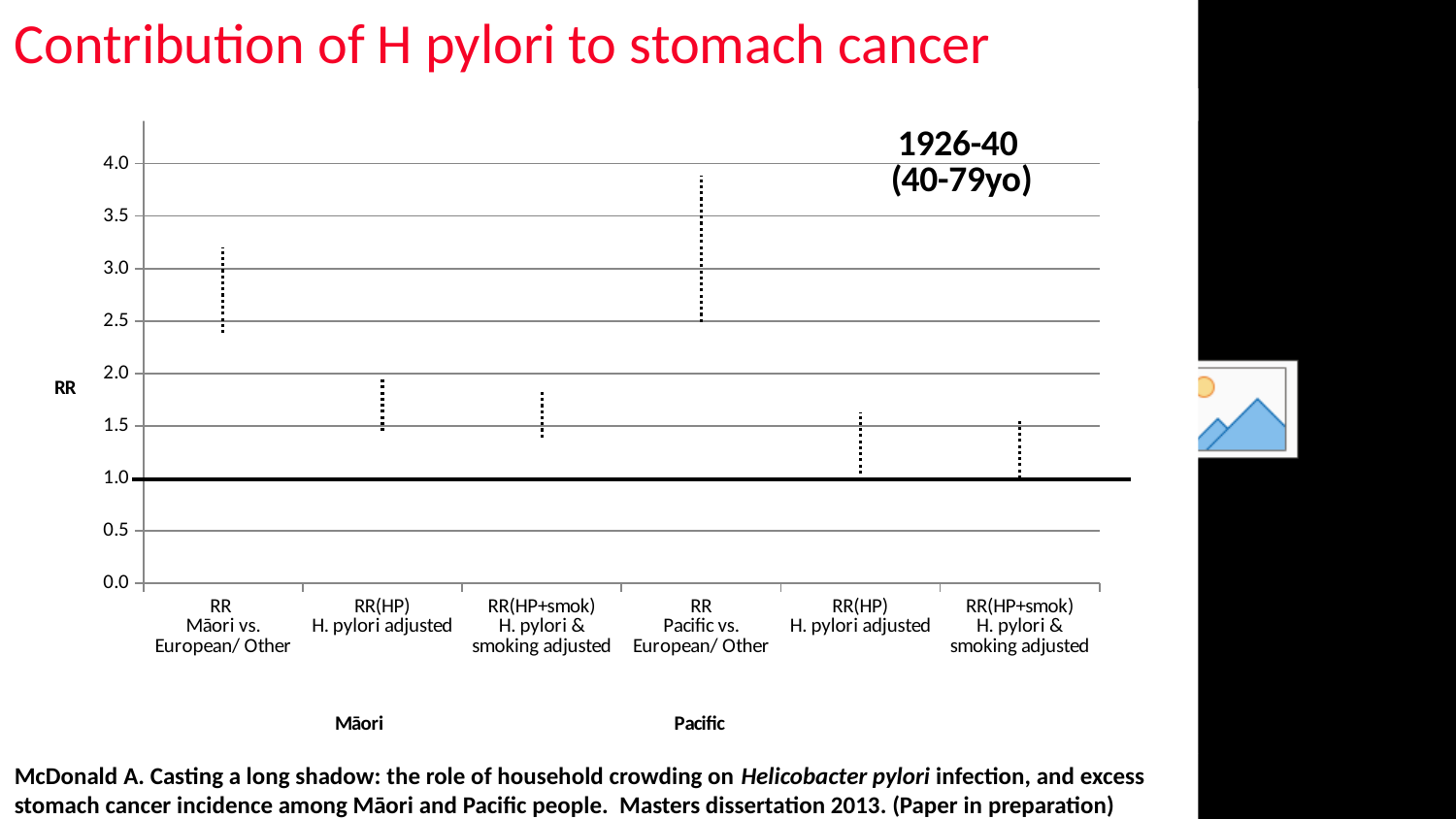
Which category has the lowest plotted range in the chart? RR(HP+smok) H. pylori & smoking adjusted (Pacific) What label is shown on the y axis of the chart? RR Is the plotted range for RR(HP) H. pylori adjusted in the Māori group greater or less than 2.0? less At what y-axis value is the solid horizontal reference line drawn in the chart? 1.0 Is the plotted range for RR Māori vs. European/Other greater or less than 2.0? greater What is the title of the slide's chart? 1926-40 (40-79yo) Which category has the highest plotted range in the chart? RR Pacific vs. European/Other Is the plotted range for RR Pacific vs. European/Other greater or less than 2.0? greater Within the Pacific group, do the plotted values rise or fall from the unadjusted RR to the H. pylori & smoking adjusted RR? fall Which is larger: the plotted range for RR Māori vs. European/Other or for RR(HP) H. pylori adjusted in the Māori group? RR Māori vs. European/Other How many categories are plotted along the x axis of the chart? 6